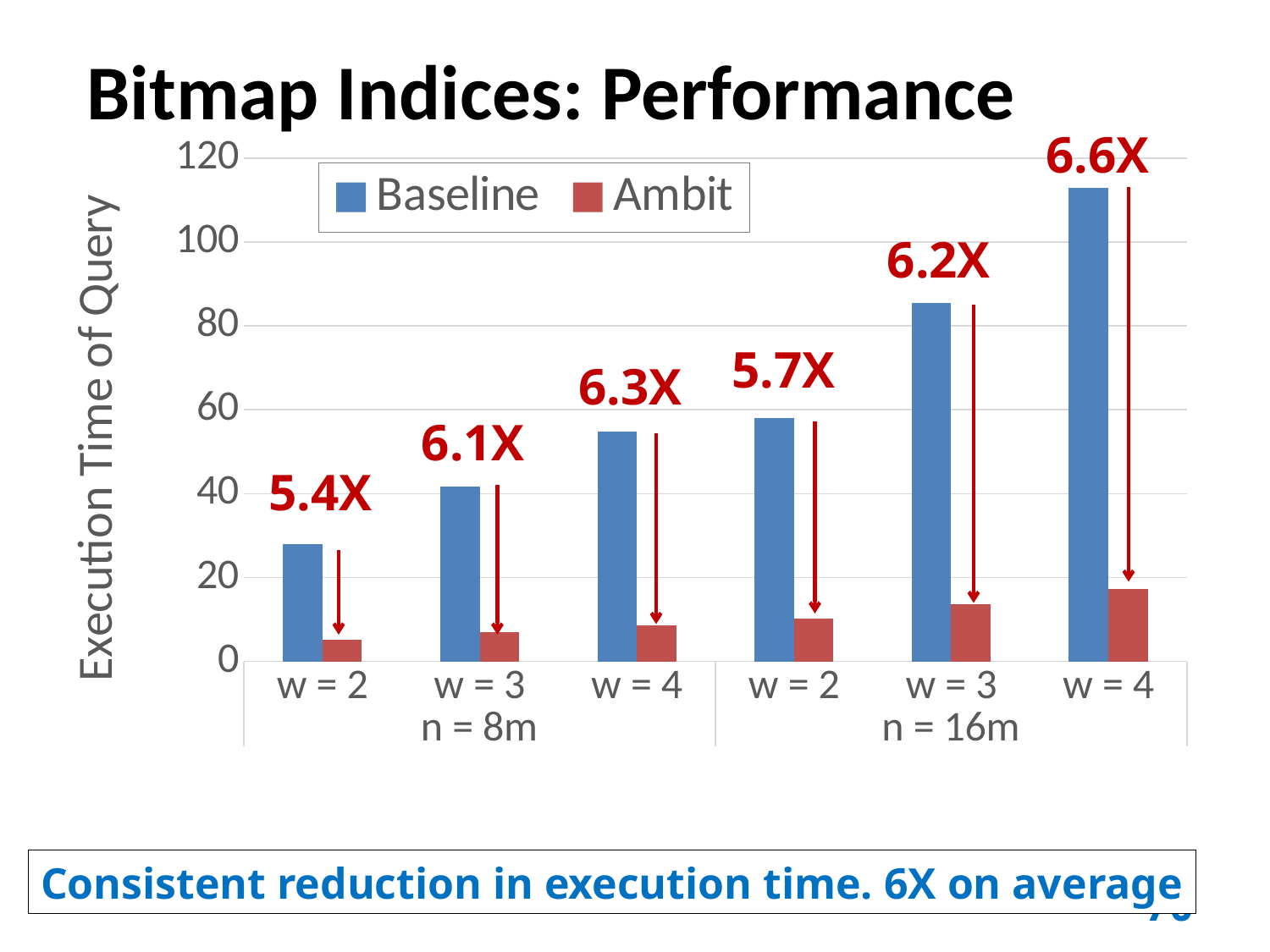
Is the Ambit value for w = 4, n = 16m greater or less than 20? less Which is larger for w = 3, n = 16m: the Baseline value or the Ambit value? Baseline Which category has the highest Baseline execution time? w = 4, n = 16m How many series does the legend list? 2 Is the Baseline value for w = 4, n = 8m greater or less than 60? less What kind of chart is shown on the slide? bar chart How many categories (bar groups) are plotted along the x axis? 6 What speedup is annotated above the w = 4, n = 16m group? 6.6X Do the Baseline values rise or fall as w increases within the n = 16m group? rise Which category has the lowest Baseline execution time? w = 2, n = 8m What speedup is annotated above the w = 3, n = 8m group? 6.1X Is the Baseline value for w = 4, n = 16m greater or less than 100? greater